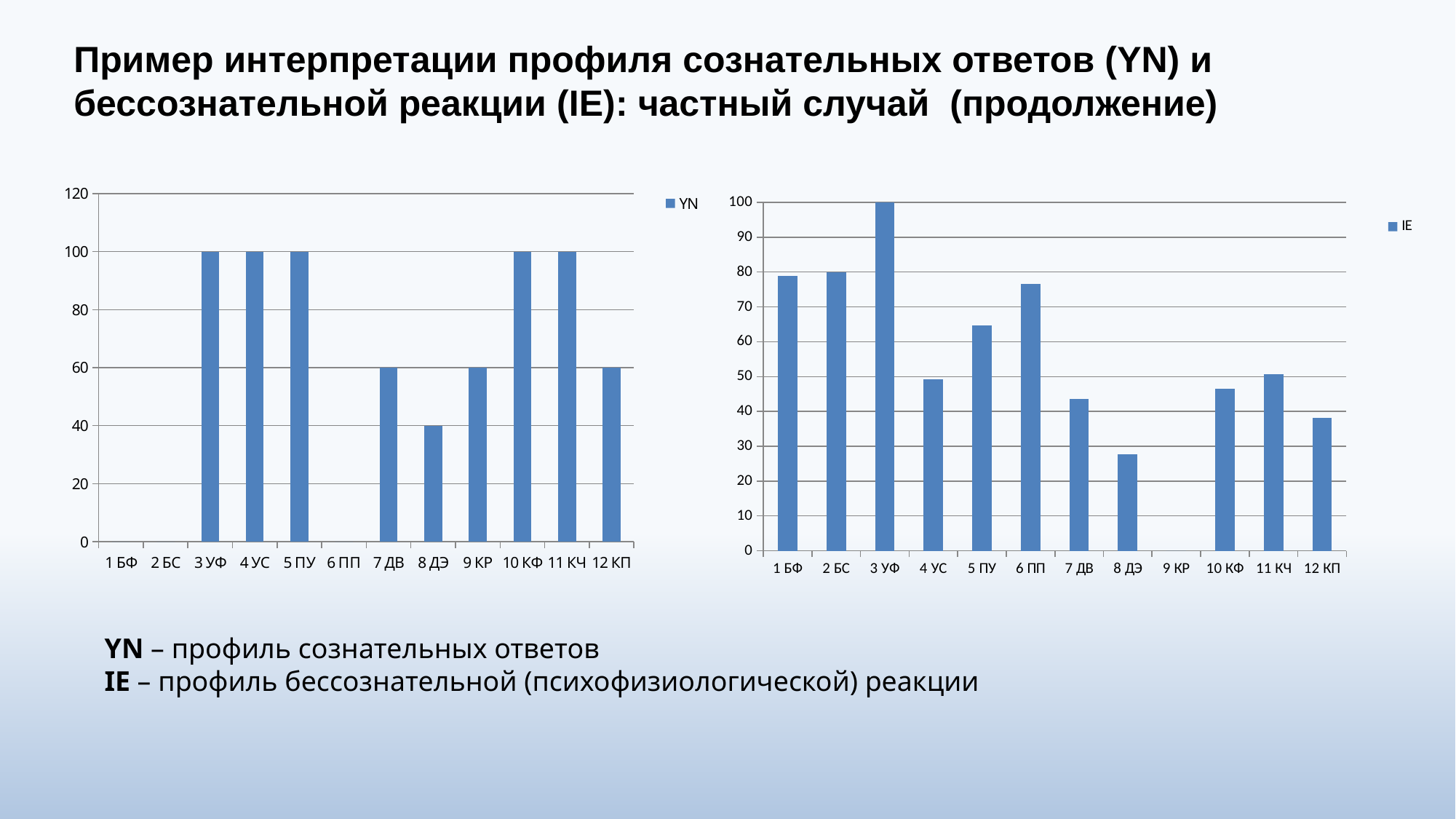
In the left chart (YN), what is the value for 8 ДЭ? 40 In the right chart (IE), is the value for 8 ДЭ greater or less than 30? less In the left chart (YN), what is the value for 12 КП? 60 How many categories are shown on the x axis of the left chart (YN)? 12 What kind of chart is the left chart (YN)? bar chart How many series does the legend of the right chart (IE) list? 1 In the right chart (IE), what is the value for 3 УФ? 100 In the right chart (IE), is the value for 6 ПП greater or less than 70? greater In the left chart (YN), what is the value for 3 УФ? 100 In the right chart (IE), which is larger, the value for 1 БФ or the value for 4 УС? 1 БФ In the left chart (YN), what is the difference between the values for 7 ДВ and 8 ДЭ? 20 In the right chart (IE), which category has the highest value? 3 УФ